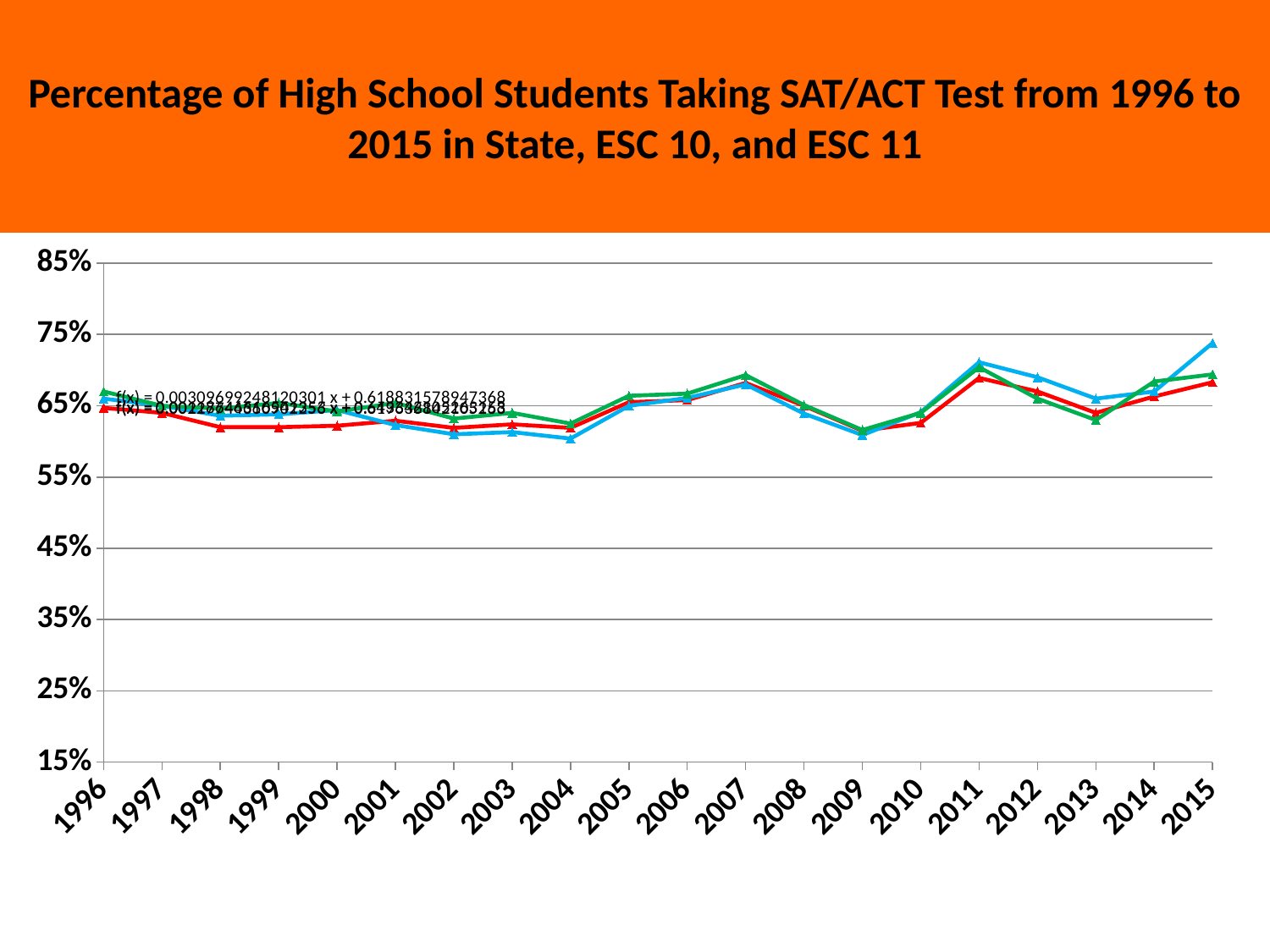
In 2015, which line has the higher value, the blue line or the red line? blue line Is the value of the blue line in 2015 greater or less than 65%? greater Are all three lines above or below 55% across every year shown? above What kind of chart is shown on the slide? line chart How many years are plotted along the x axis of the chart? 20 What is the title of the chart on the slide? Percentage of High School Students Taking SAT/ACT Test from 1996 to 2015 in State, ESC 10, and ESC 11 Does the blue line rise or fall between 2011 and 2013? fall Is the value of the blue line in 2004 greater or less than 65%? less In which year does the blue line reach its highest value? 2015 For the blue line, is the value in 2011 higher or lower than the value in 2009? higher How many lines are plotted on the chart? 3